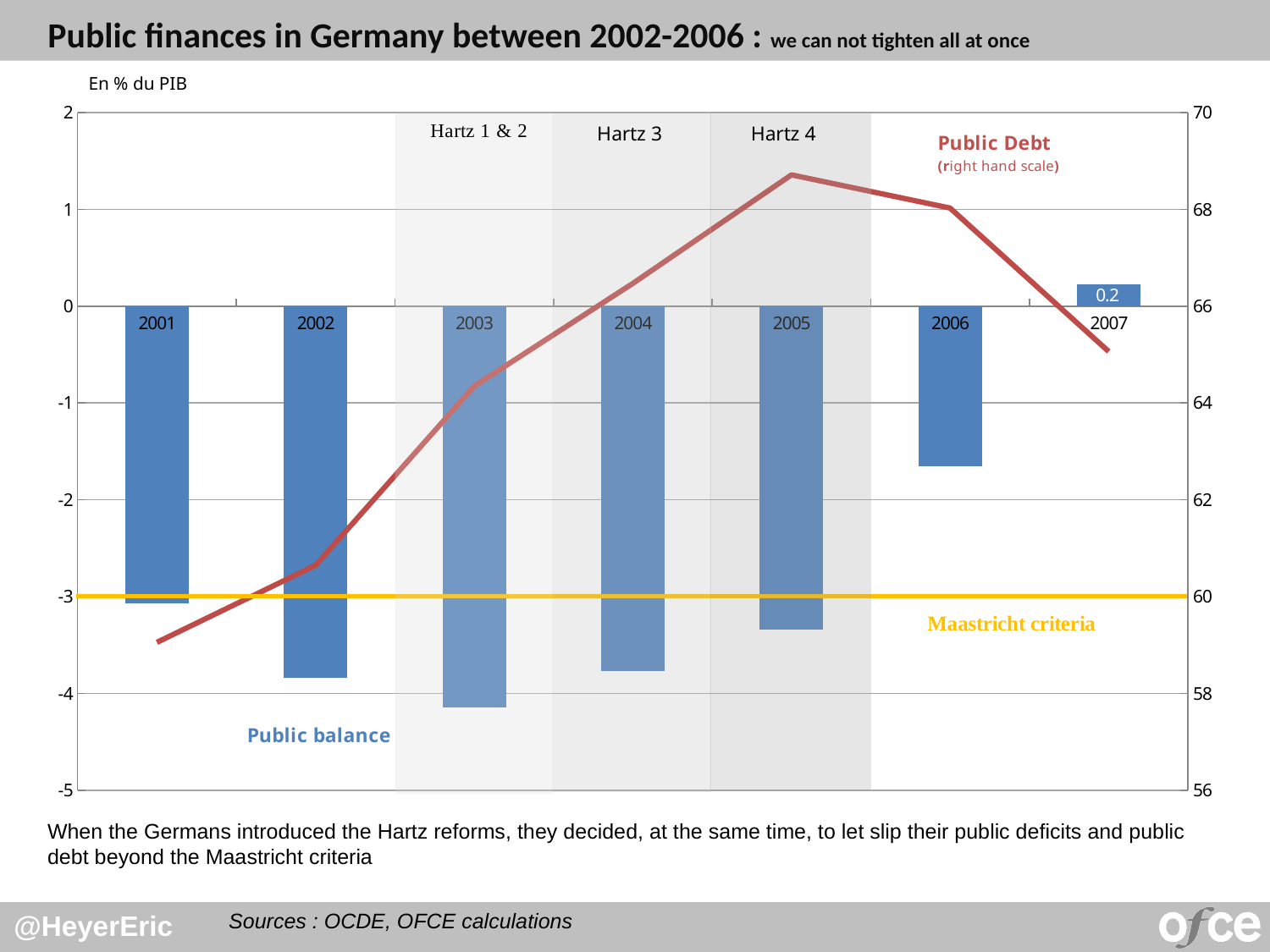
What is the public balance value shown for 2007? 0.2 Does the public debt line rise or fall between 2001 and 2005? rise What kind of chart is used to show the public balance? bar chart Is the public debt value for 2001 greater or less than 60 on the right-hand scale? less Which year has the higher public balance, 2004 or 2006? 2006 Is the public balance for 2003 greater or less than -4? less Is the public debt value for 2005 greater or less than 68 on the right-hand scale? greater Which year has the highest public balance? 2007 How many years are shown on the x axis of the chart? 7 Which series is plotted on the right-hand scale? Public Debt Which year has the lowest public balance bar? 2003